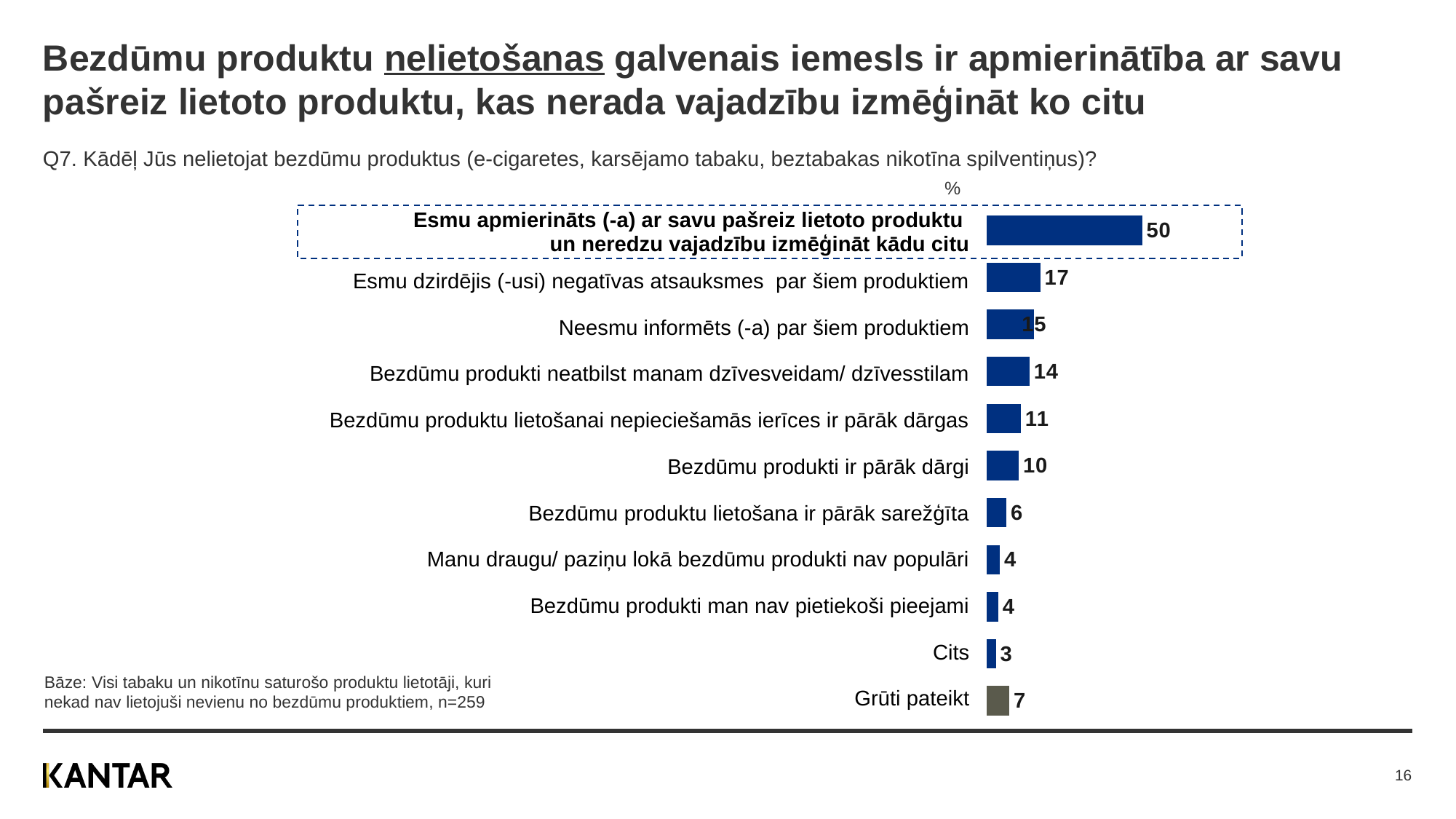
How many categories are shown in the chart? 11 Which bar is shown in a different (grey) colour from the others? Grūti pateikt What is the difference between the values for "Bezdūmu produktu lietošana ir pārāk sarežģīta" and "Cits"? 3 What kind of chart is shown on the slide? Bar chart What is the value for "Bezdūmu produkti ir pārāk dārgi"? 10 What is the value for "Esmu dzirdējis (-usi) negatīvas atsauksmes par šiem produktiem"? 17 What is the value for "Grūti pateikt"? 7 Which is larger: the value for "Bezdūmu produktu lietošanai nepieciešamās ierīces ir pārāk dārgas" or for "Bezdūmu produkti ir pārāk dārgi"? Bezdūmu produktu lietošanai nepieciešamās ierīces ir pārāk dārgas Which category has the lowest value? Cits What is the difference between the values for "Esmu apmierināts (-a) ar savu pašreiz lietoto produktu un neredzu vajadzību izmēģināt kādu citu" and "Esmu dzirdējis (-usi) negatīvas atsauksmes par šiem produktiem"? 33 What is the value for "Esmu apmierināts (-a) ar savu pašreiz lietoto produktu un neredzu vajadzību izmēģināt kādu citu"? 50 Which category has the highest value? Esmu apmierināts (-a) ar savu pašreiz lietoto produktu un neredzu vajadzību izmēģināt kādu citu